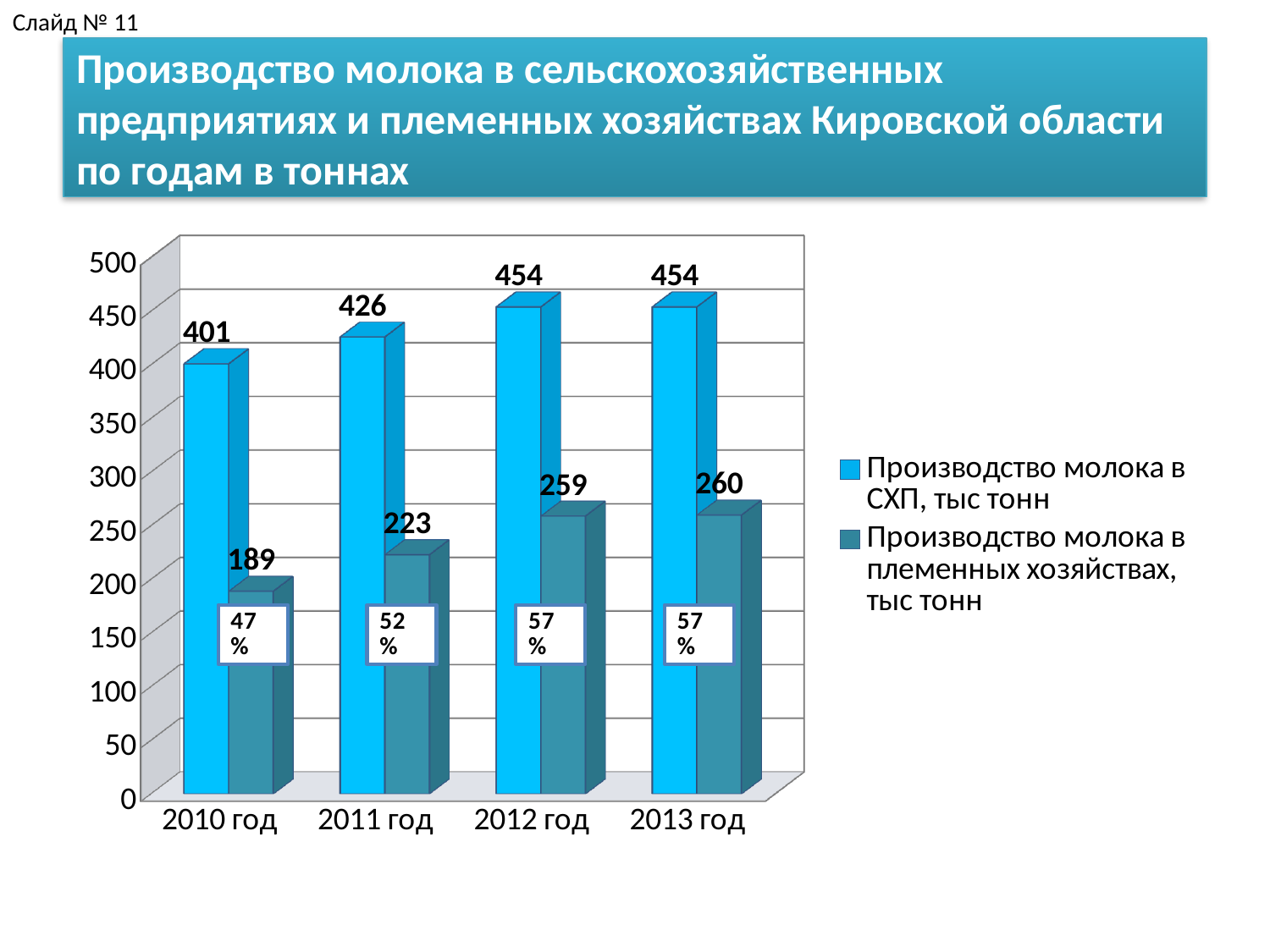
Which year has the lowest value for 'Производство молока в племенных хозяйствах, тыс тонн'? 2010 год Which is larger: 'Производство молока в СХП, тыс тонн' in 2011 год or in 2012 год? 2012 год What is the value for 'Производство молока в СХП, тыс тонн' in 2011 год? 426 What percentage label is shown inside the 2010 год bars? 47% What is the value for 'Производство молока в СХП, тыс тонн' in 2010 год? 401 What kind of chart is shown on the slide? bar chart How many years are shown on the x axis? 4 What is the difference in 'Производство молока в племенных хозяйствах, тыс тонн' between 2011 год and 2010 год? 34 What is the difference between 'Производство молока в СХП, тыс тонн' and 'Производство молока в племенных хозяйствах, тыс тонн' in 2013 год? 194 What is the value for 'Производство молока в племенных хозяйствах, тыс тонн' in 2012 год? 259 How many series does the legend list? 2 Does 'Производство молока в племенных хозяйствах, тыс тонн' rise or fall from 2010 год to 2013 год? rise